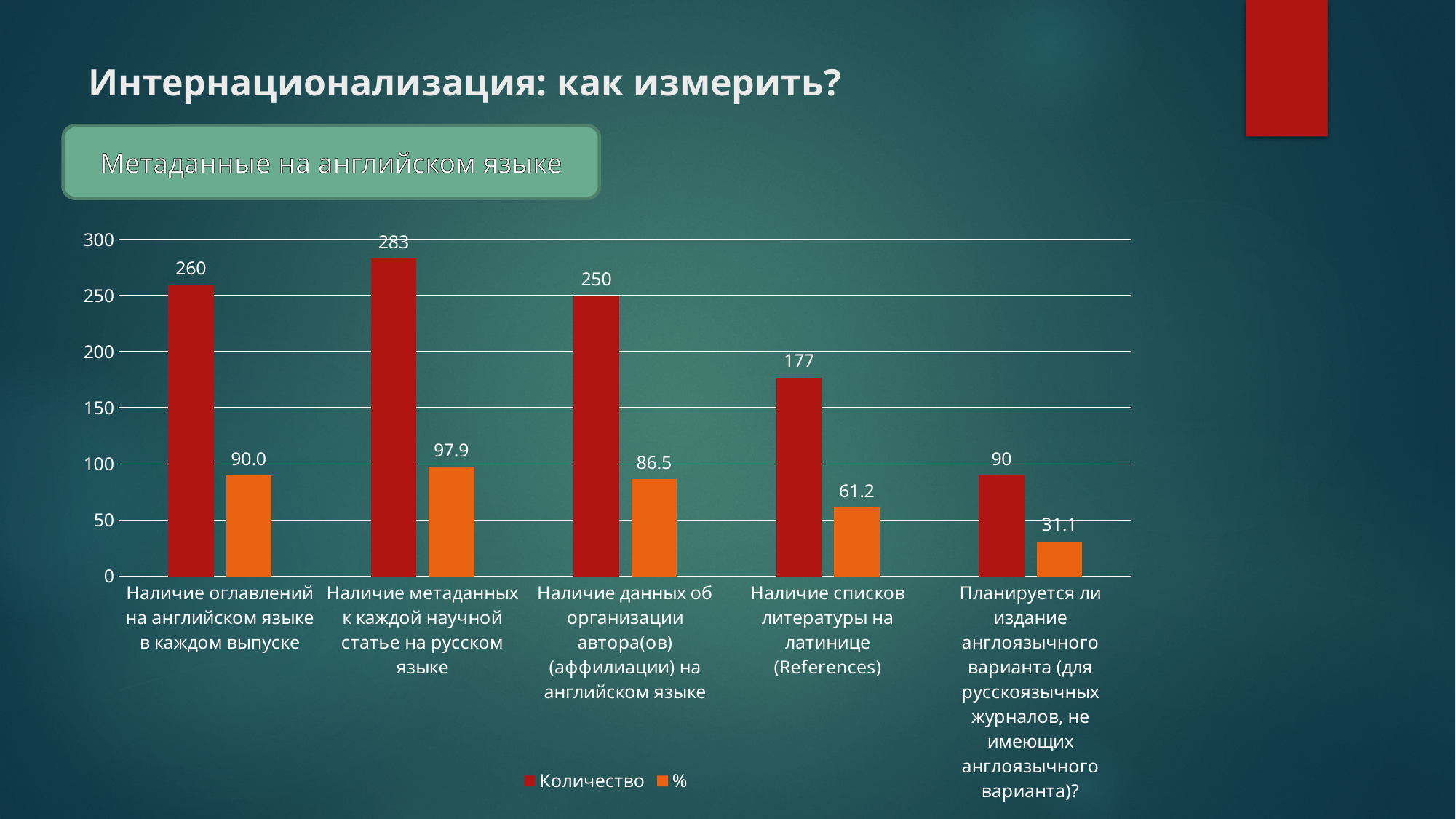
How many categories are shown on the x axis? 5 What is the difference between the Количество values for 'Наличие метаданных к каждой научной статье на русском языке' and 'Наличие данных об организации автора(ов) (аффилиации) на английском языке'? 33 How many series does the legend list? 2 Which is larger: the % value for 'Наличие оглавлений на английском языке в каждом выпуске' or for 'Наличие данных об организации автора(ов) (аффилиации) на английском языке'? Наличие оглавлений на английском языке в каждом выпуске What kind of chart is shown on the slide? bar chart What is the Количество value for 'Наличие оглавлений на английском языке в каждом выпуске'? 260 Which category has the lowest % value? Планируется ли издание англоязычного варианта (для русскоязычных журналов, не имеющих англоязычного варианта)? What is the % value for 'Наличие списков литературы на латинице (References)'? 61.2 Is the Количество value for 'Наличие списков литературы на латинице (References)' greater or less than 150? greater What is the Количество value for 'Наличие метаданных к каждой научной статье на русском языке'? 283 What colour are the bars for the % series? orange Which category has the highest Количество value? Наличие метаданных к каждой научной статье на русском языке